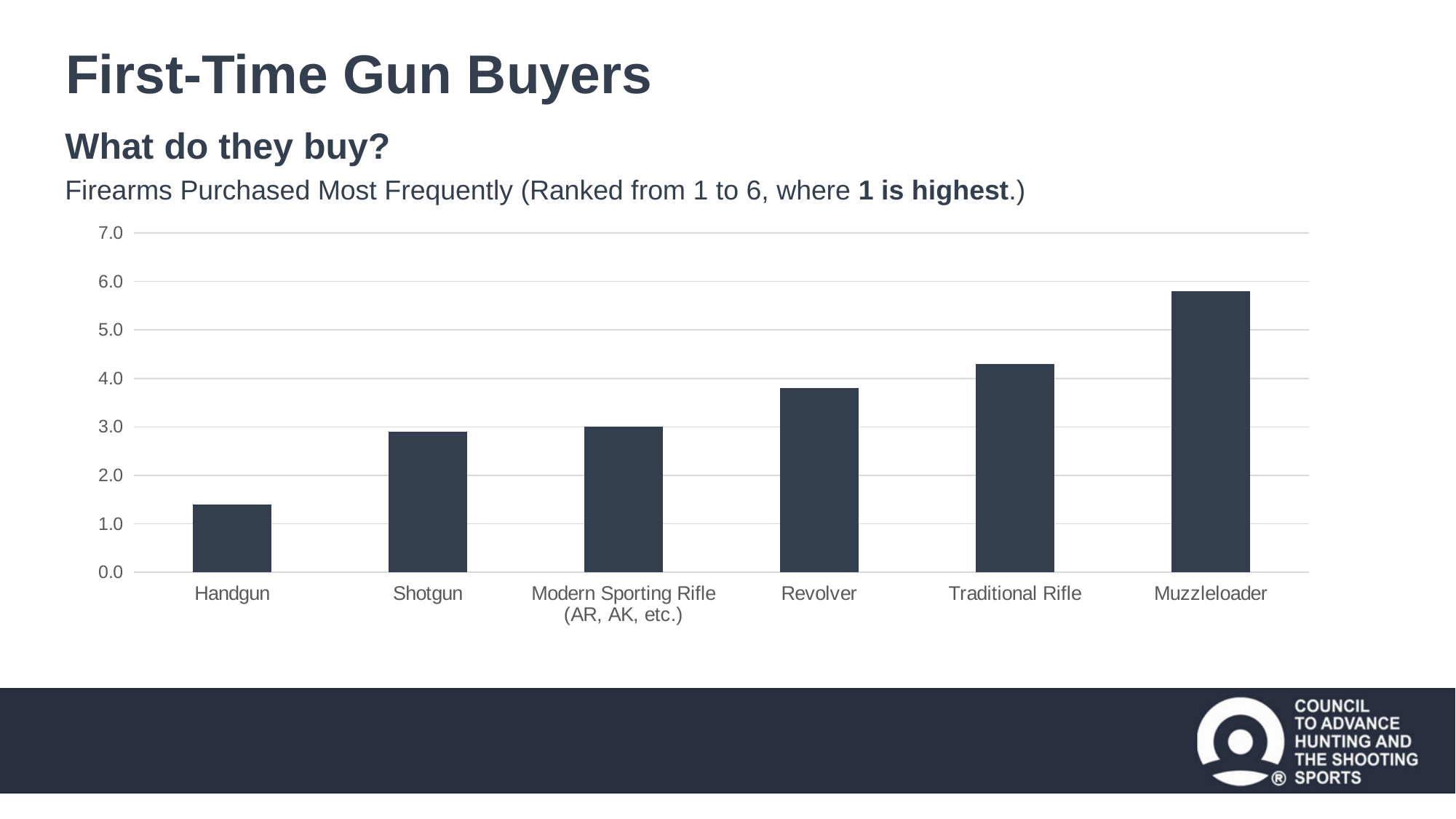
Is the value for Handgun greater or less than 2.0? less Which category has the highest bar on the chart? Muzzleloader Which has the larger value, Revolver or Shotgun? Revolver Which has the larger value, Traditional Rifle or Muzzleloader? Muzzleloader What kind of chart is shown on the slide? Bar chart Is the value for Muzzleloader greater or less than 5.0? greater Which category has the lowest bar on the chart? Handgun Is the value for Revolver greater or less than 4.0? less How many firearm categories are shown on the chart? 6 Do the bar values rise or fall from left to right across the categories? Rise What is the highest value shown on the vertical axis? 7.0